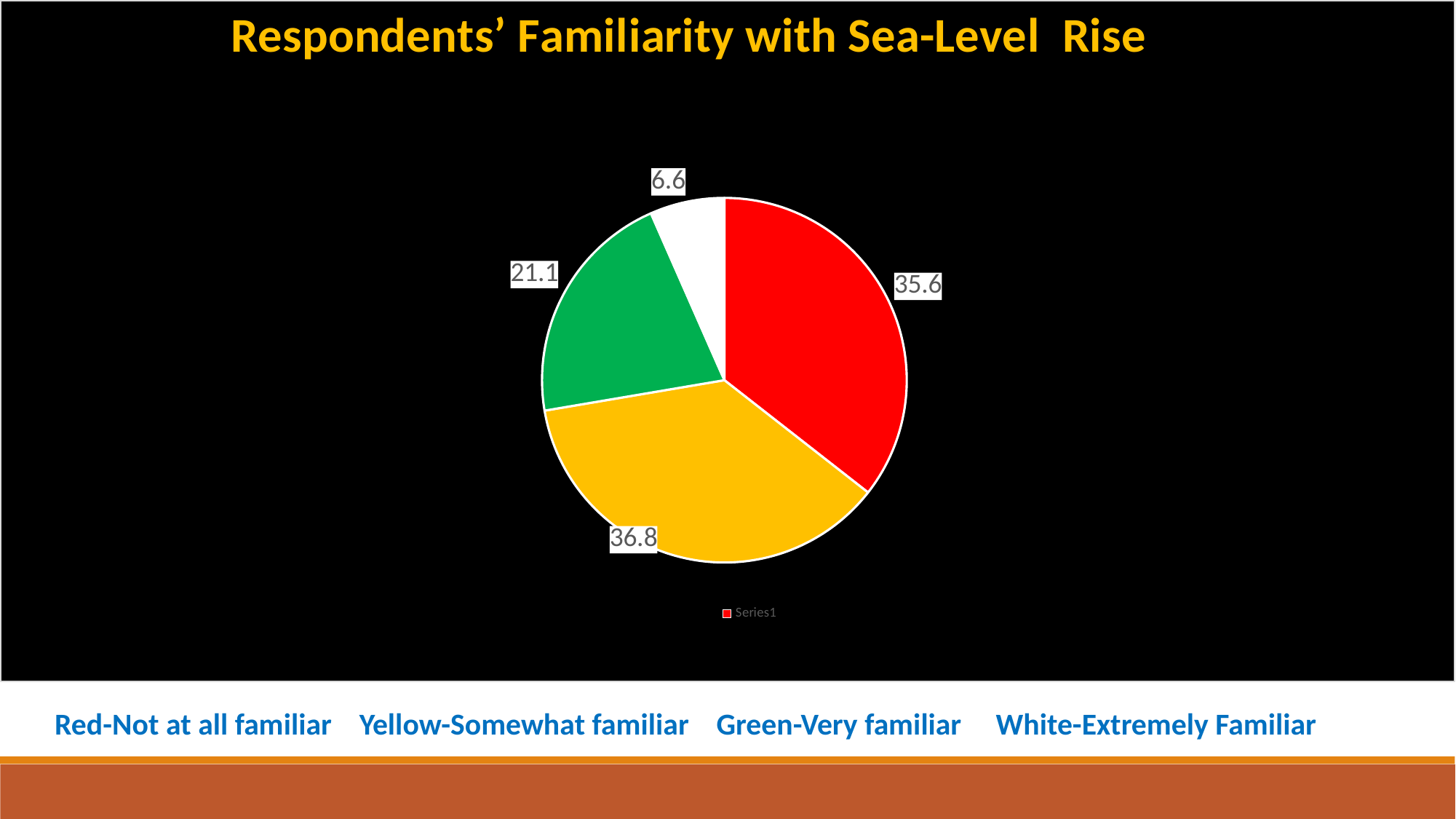
What is the difference between the Somewhat familiar and Not at all familiar values? 1.2 What is the title of the chart? Respondents' Familiarity with Sea-Level Rise Which familiarity category has the smallest slice? Extremely Familiar What value is shown for the Somewhat familiar (yellow) slice? 36.8 Which is larger, the Very familiar slice or the Extremely Familiar slice? Very familiar Which familiarity category has the largest slice? Somewhat familiar What kind of chart is shown on the slide? Pie chart How many slices does the pie chart have? 4 What is the difference between the Very familiar and Extremely Familiar values? 14.5 What value is shown for the Not at all familiar (red) slice? 35.6 What value is shown for the Extremely Familiar (white) slice? 6.6 What value is shown for the Very familiar (green) slice? 21.1